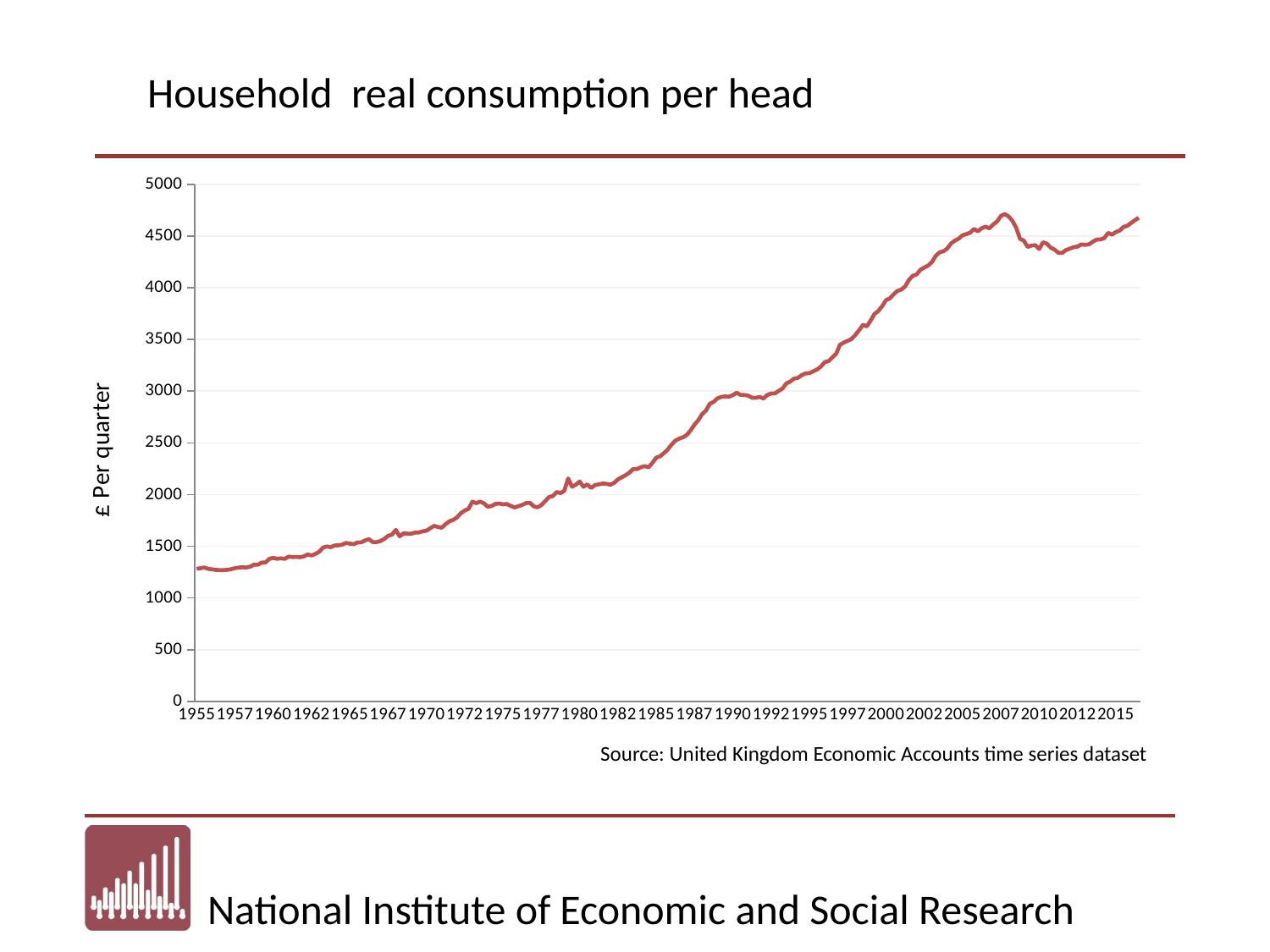
Which year has the higher value, 1955 or 2015? 2015 Which year has the higher value, 2007 or 2010? 2007 Is the value for 2015 greater or less than 4500? greater What is the title of the chart? Household real consumption per head Is the value for 1955 greater or less than 1500? less What is the label on the vertical axis of the chart? £ Per quarter Is the value for 2007 greater or less than 4500? greater What kind of chart is shown on the slide? line chart Overall, does household real consumption per head rise or fall from 1955 to 2015? rise